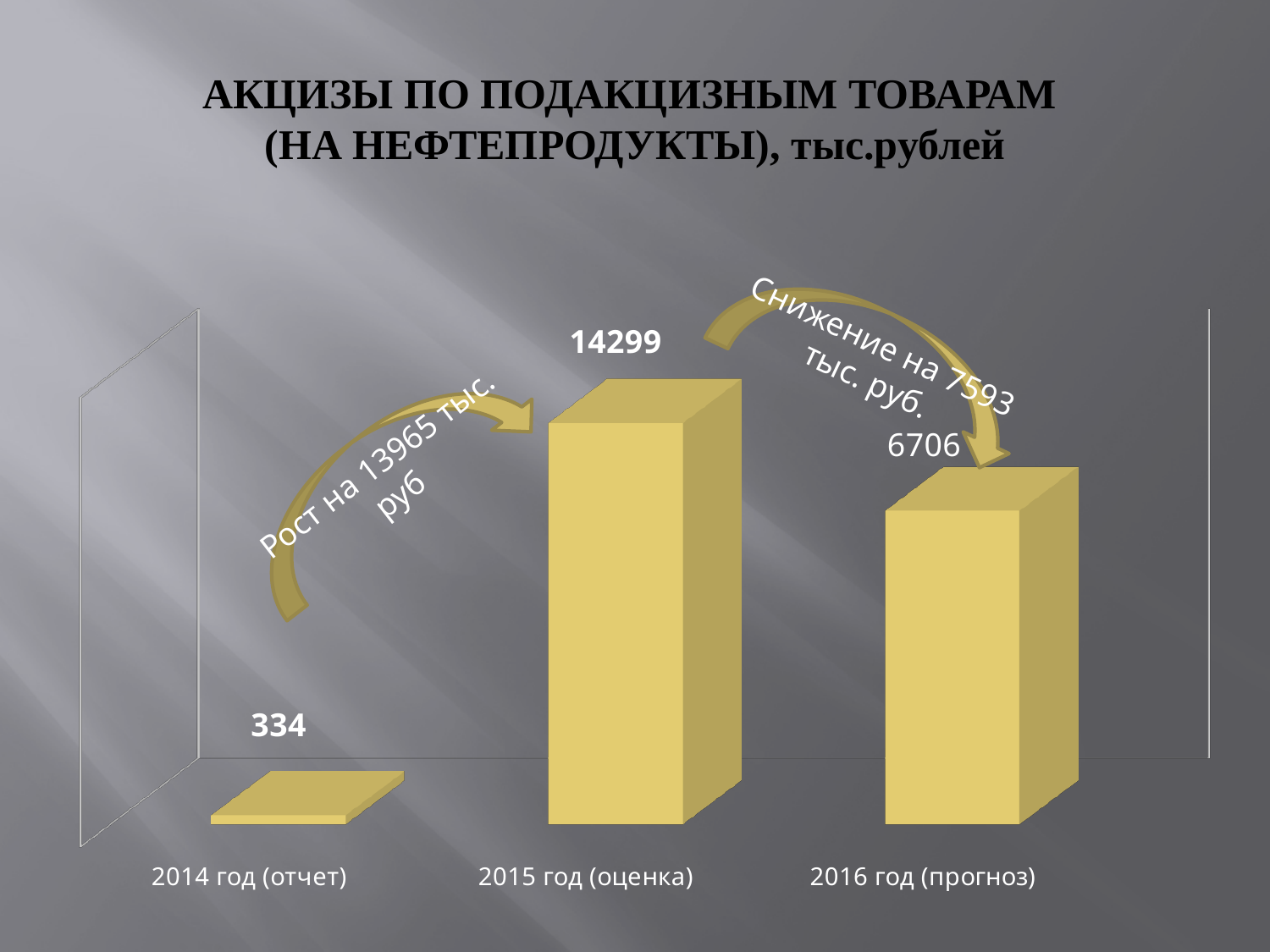
Which year has the highest value? 2015 год (оценка) What is the value for 2015 год (оценка)? 14299 How many categories are shown in the chart? 3 What is the difference between the values for 2015 год (оценка) and 2016 год (прогноз)? 7593 What unit is stated in the chart title? тыс.рублей What kind of chart is shown on the slide? bar chart What is the value for 2016 год (прогноз)? 6706 Which year has the lowest value? 2014 год (отчет) What is the value for 2014 год (отчет)? 334 Which is larger, the value for 2016 год (прогноз) or the value for 2014 год (отчет)? 2016 год (прогноз) Does the value rise or fall from 2015 год (оценка) to 2016 год (прогноз)? fall What is the difference between the values for 2015 год (оценка) and 2014 год (отчет)? 13965